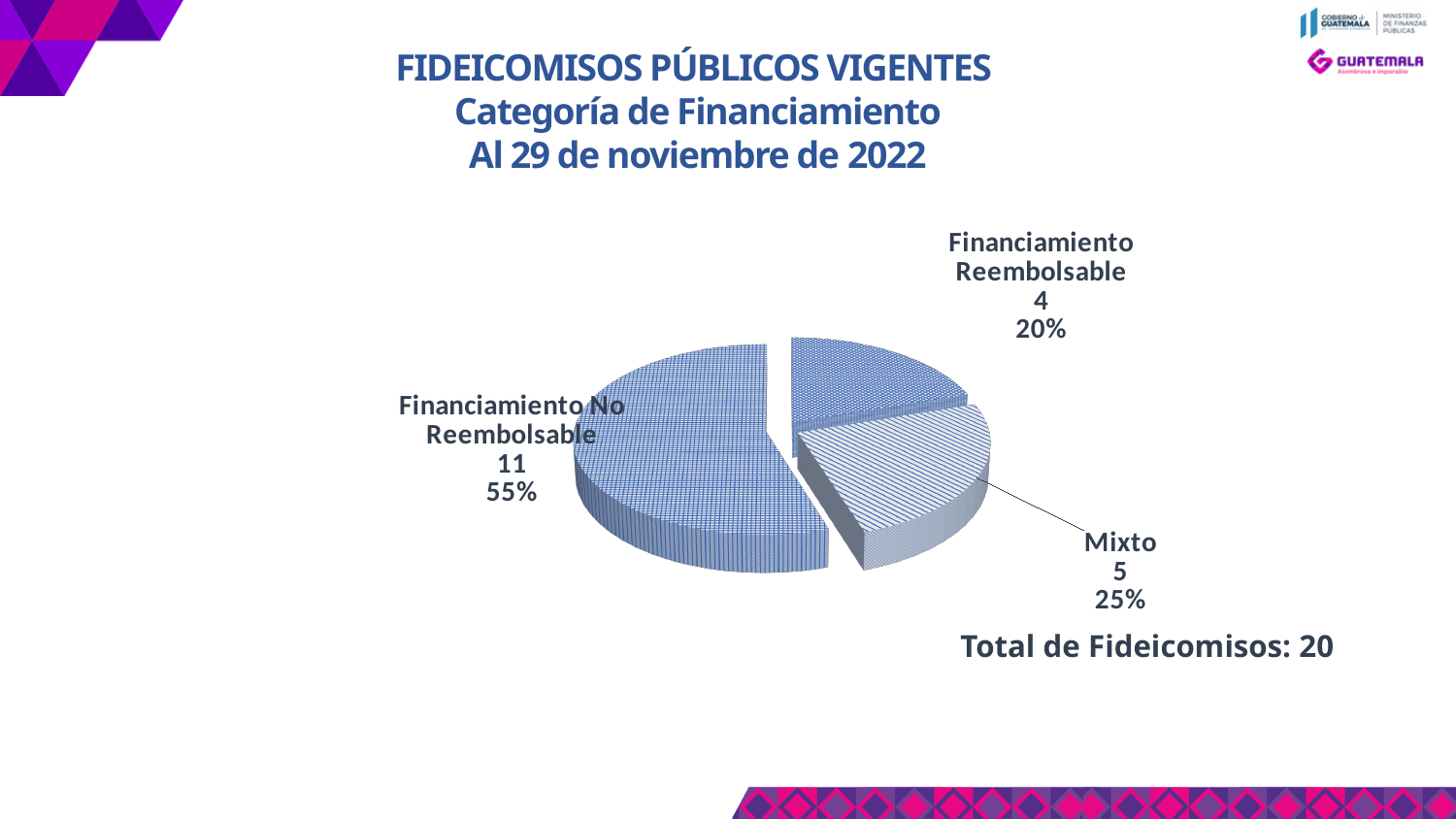
How many fideicomisos are in the Financiamiento Reembolsable category? 4 What share of the pie does Financiamiento Reembolsable represent? 20% How many fideicomisos are in the Financiamiento No Reembolsable category? 11 What is the difference in the number of fideicomisos between Financiamiento No Reembolsable and Mixto? 6 What kind of chart is shown on the slide? Pie chart What is the total number of fideicomisos shown on the slide? 20 What share of the pie does Financiamiento No Reembolsable represent? 55% Which category has the smallest number of fideicomisos? Financiamiento Reembolsable How many categories does the pie chart show? 3 How many fideicomisos are in the Mixto category? 5 What share of the pie does Mixto represent? 25% Which category has the largest number of fideicomisos? Financiamiento No Reembolsable